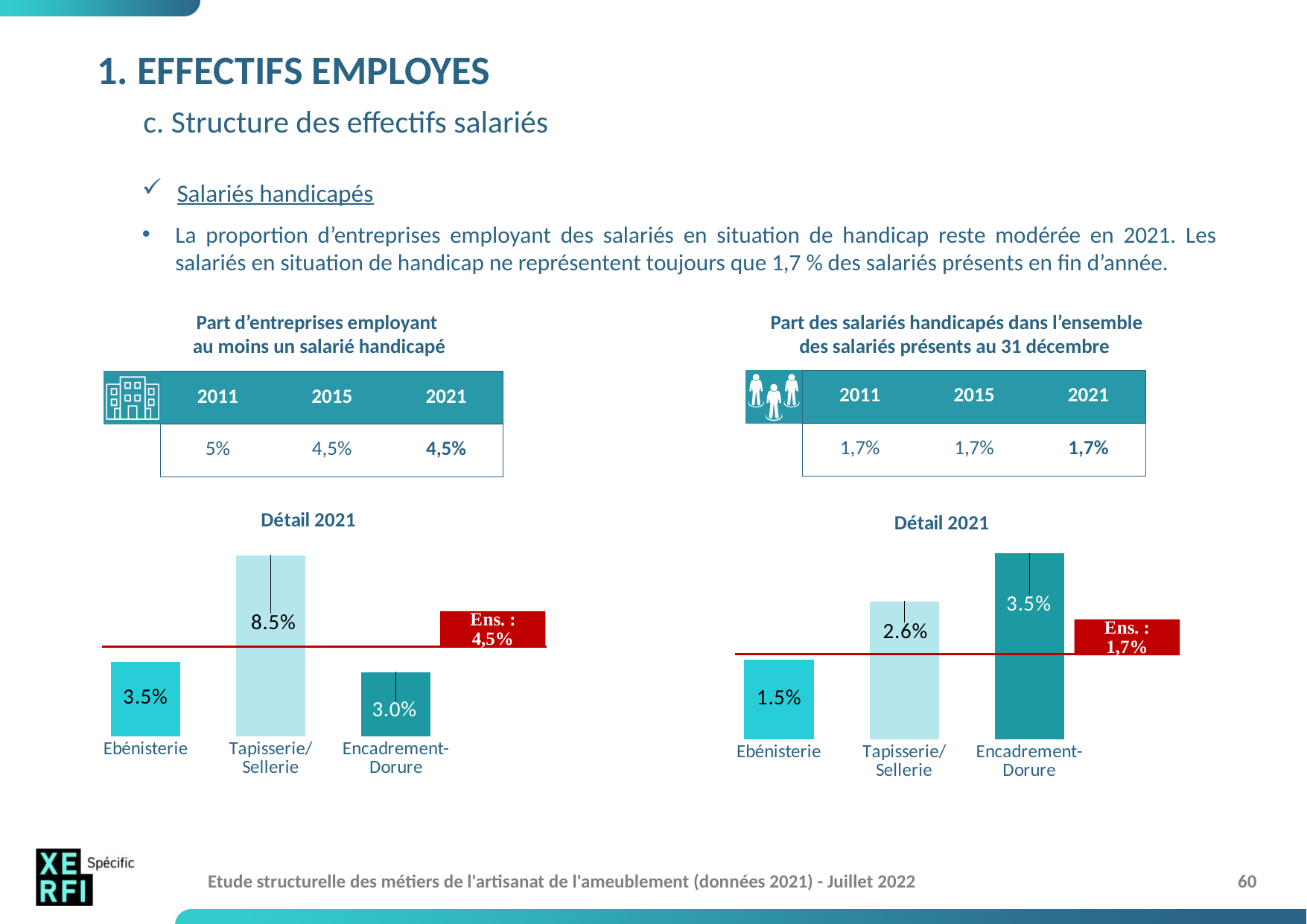
In the left 'Détail 2021' chart, which category has the highest value? Tapisserie/Sellerie In the left 'Détail 2021' chart, what is the value for Tapisserie/Sellerie? 8.5% In the right 'Détail 2021' chart, what is the value for Encadrement-Dorure? 3.5% In the right 'Détail 2021' chart, what overall value ('Ens.') is shown on the red reference label? 1,7% In the right 'Détail 2021' chart, which category has the lowest value? Ebénisterie In the right 'Détail 2021' chart, what is the value for Ebénisterie? 1.5% In the left 'Détail 2021' chart, what is the difference between Tapisserie/Sellerie and Ebénisterie? 5.0% What kind of chart is the right 'Détail 2021' chart? Bar chart In the left 'Détail 2021' chart, what is the value for Encadrement-Dorure? 3.0% How many categories are shown in the left 'Détail 2021' chart? 3 In the right 'Détail 2021' chart, what is the difference between Encadrement-Dorure and Tapisserie/Sellerie? 0.9% In the right 'Détail 2021' chart, which is larger, Tapisserie/Sellerie or Ebénisterie? Tapisserie/Sellerie